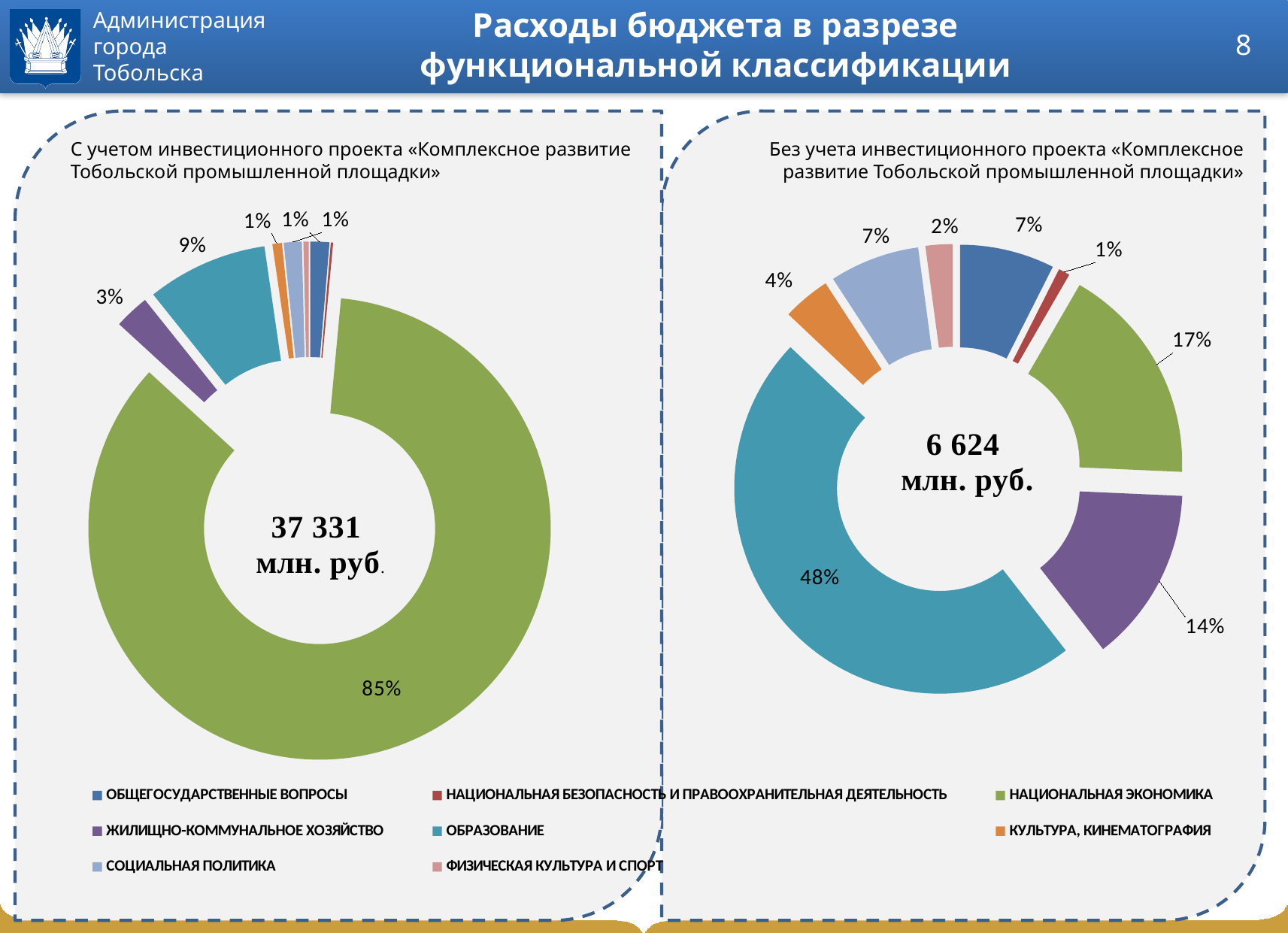
In the right chart (Без учета инвестиционного проекта), what share does ЖИЛИЩНО-КОММУНАЛЬНОЕ ХОЗЯЙСТВО have? 14% In the left chart (С учетом инвестиционного проекта), which is larger: ОБРАЗОВАНИЕ or ЖИЛИЩНО-КОММУНАЛЬНОЕ ХОЗЯЙСТВО? ОБРАЗОВАНИЕ In the right chart (Без учета инвестиционного проекта), what share does НАЦИОНАЛЬНАЯ ЭКОНОМИКА have? 17% What total amount is shown in the centre of the left chart (С учетом инвестиционного проекта)? 37 331 млн. руб. In the right chart (Без учета инвестиционного проекта), what share does ОБРАЗОВАНИЕ have? 48% What total amount is shown in the centre of the right chart (Без учета инвестиционного проекта)? 6 624 млн. руб. How many categories does the legend list? 8 In the right chart (Без учета инвестиционного проекта), which category has the largest share? ОБРАЗОВАНИЕ In the right chart (Без учета инвестиционного проекта), which category has the smallest share? НАЦИОНАЛЬНАЯ БЕЗОПАСНОСТЬ И ПРАВООХРАНИТЕЛЬНАЯ ДЕЯТЕЛЬНОСТЬ